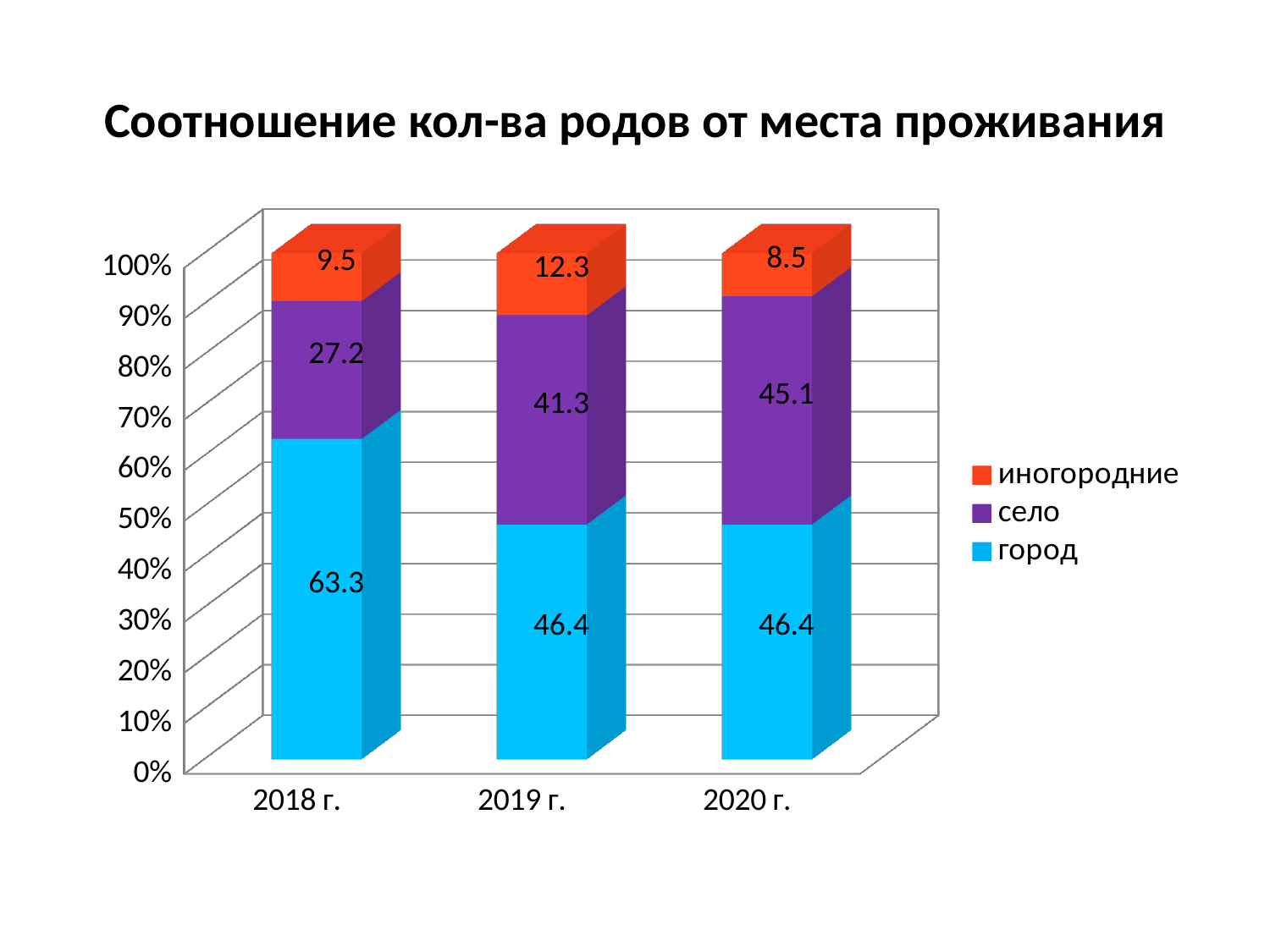
In which year is the value for иногородние highest? 2019 г. How many series does the legend list? 3 What kind of chart is shown on the slide? Stacked bar chart What is the value for город in 2018 г.? 63.3 Which is larger in 2019 г., the value for город or the value for село? город How many years are shown on the x axis? 3 In which year is the value for село lowest? 2018 г. What is the difference between the село values for 2020 г. and 2018 г.? 17.9 What is the value for иногородние in 2020 г.? 8.5 Which series is shown in orange in the legend? иногородние What is the value for село in 2020 г.? 45.1 What is the value for село in 2019 г.? 41.3